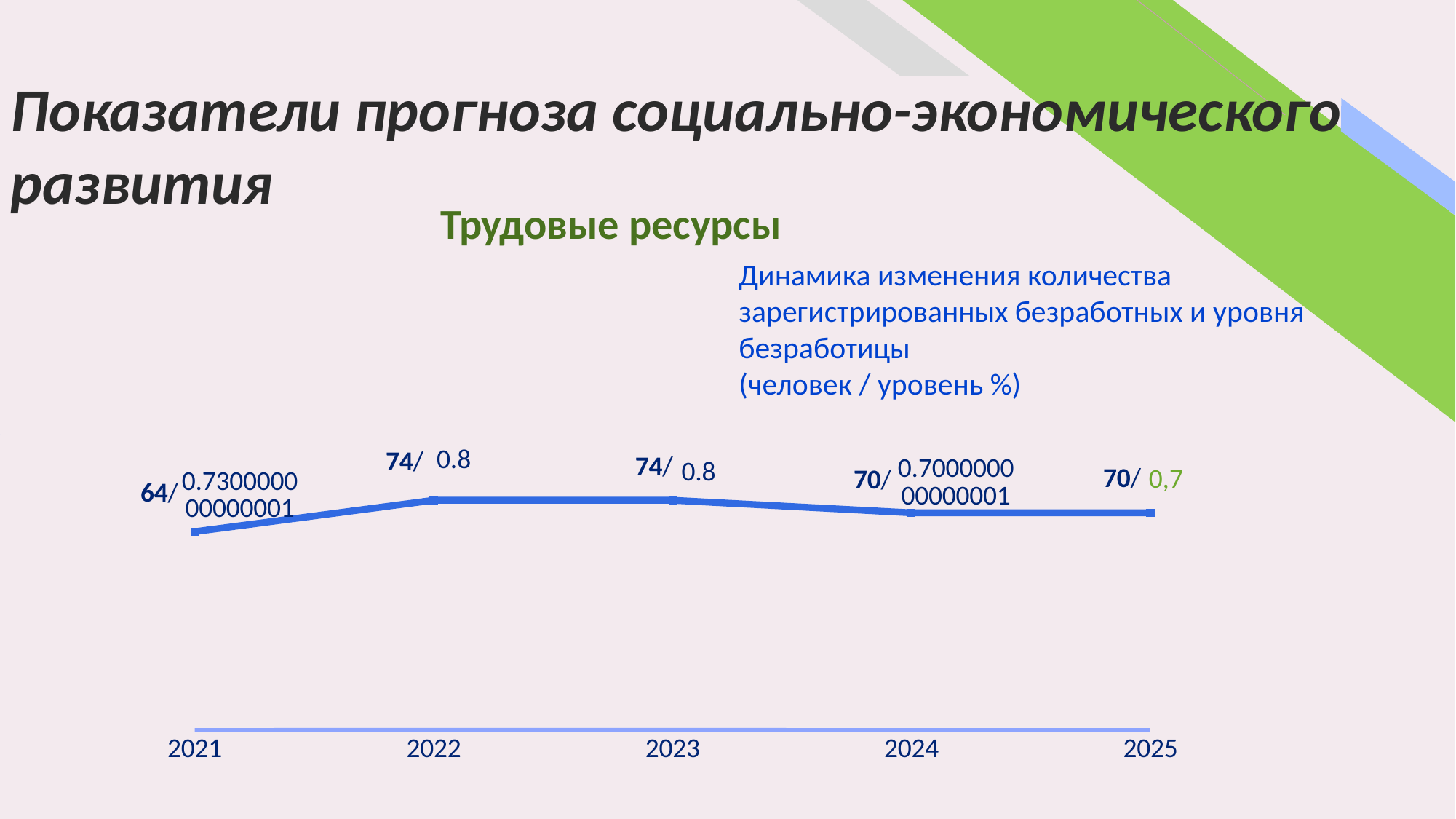
What is the number of registered unemployed shown for 2022? 74 In which year is the number of registered unemployed the lowest? 2021 How many years are plotted on the x axis of the chart? 5 What kind of chart is used to show the dynamics of registered unemployed? Line chart What is the number of registered unemployed shown for 2024? 70 Does the number of registered unemployed rise or fall from 2021 to 2022? Rise What unemployment rate (%) is shown for 2025? 0,7 Which year has a larger number of registered unemployed, 2021 or 2025? 2025 What is the difference in the number of registered unemployed between 2022 and 2021? 10 What is the number of registered unemployed shown for 2021? 64 What is the green heading above the chart? Трудовые ресурсы What unemployment rate (%) is shown for 2023? 0.8